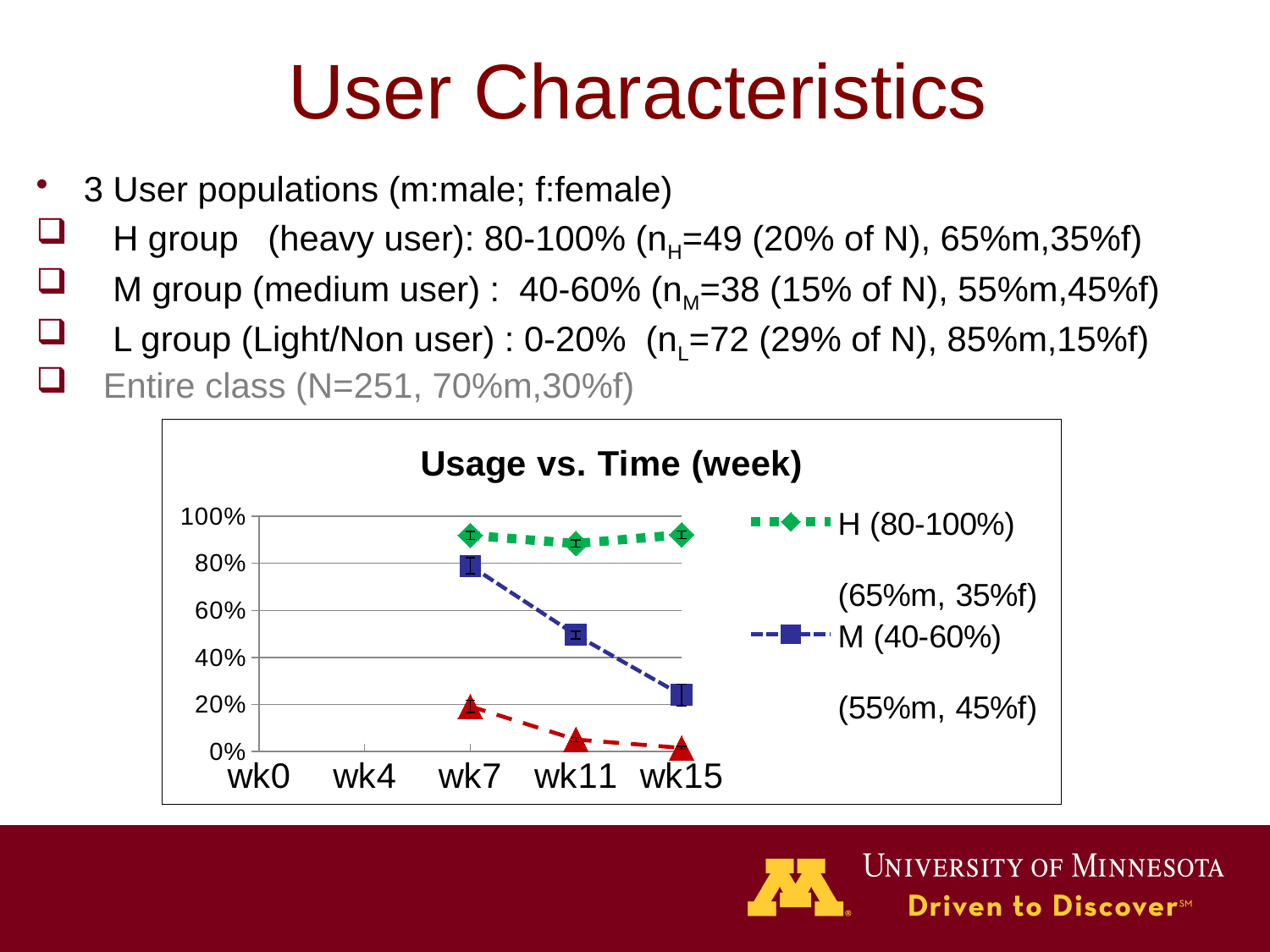
What is the title of the chart? Usage vs. Time (week) Is the value for M (40-60%) at wk7 greater or less than 60%? greater Is the value for M (40-60%) at wk15 greater or less than 40%? less Is the value for H (80-100%) at wk11 greater or less than 80%? greater What is the first week label on the x axis of the chart? wk0 Does the M (40-60%) series rise or fall from wk7 to wk15? fall Which legend series has the highest value at wk11? H (80-100%) How many week labels are shown on the x axis of the chart? 5 How many series does the chart's legend list? 2 What kind of chart is shown on the slide? line chart At wk15, which series has the larger value, H (80-100%) or M (40-60%)? H (80-100%)